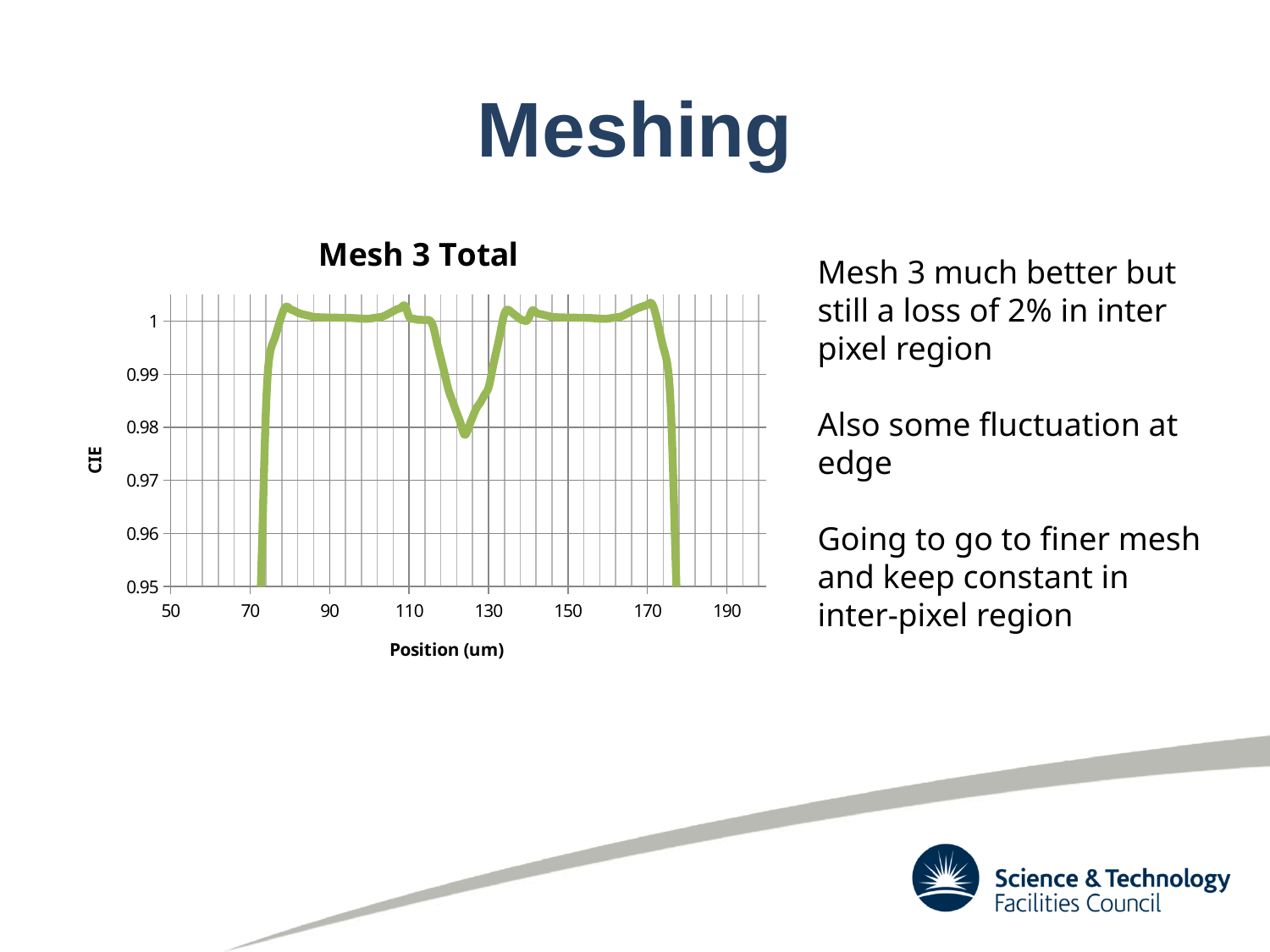
What is the highest position value labelled on the x axis of the chart? 190 How many tick labels are shown on the x axis of the chart? 8 What is the lowest value shown on the y axis of the chart? 0.95 Does the line rise or fall between position 124 um and position 135 um? rise What is the title of the chart? Mesh 3 Total What is the label of the x axis of the chart? Position (um) Does the line rise or fall between position 110 um and position 124 um? fall Is the value for position 90 um greater or less than 0.99? greater What kind of chart is shown on the slide? line chart Is the value at the dip near position 124 um greater or less than 0.99? less Is the value for position 100 um greater or less than 0.96? greater